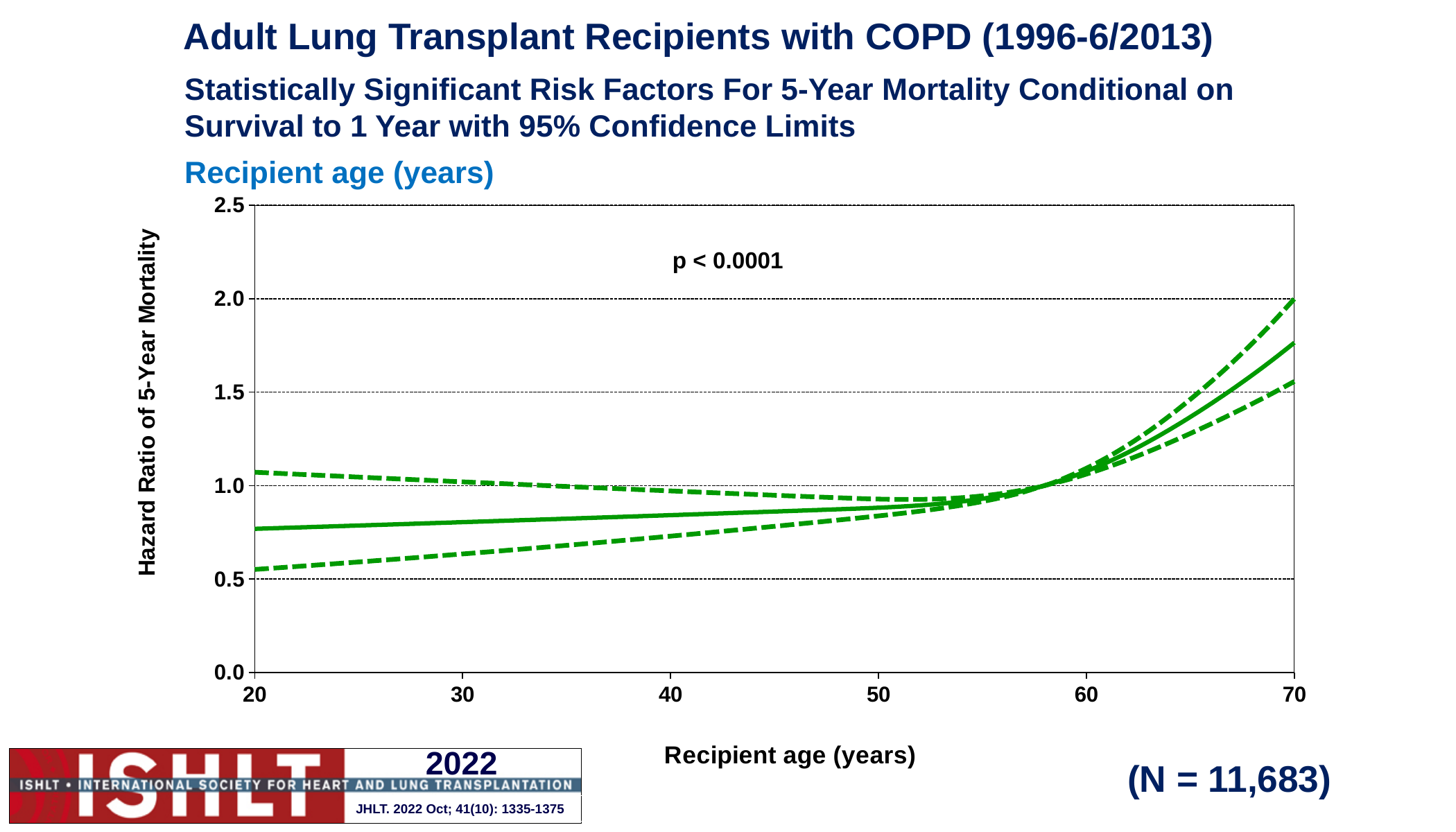
Is the hazard ratio on the solid line at recipient age 60 greater or less than 1.0? greater How many lines are plotted on the chart? 3 What p-value is printed on the chart? p < 0.0001 Does the upper dashed confidence limit rise or fall between recipient age 20 and 50? fall Is the hazard ratio on the solid line at recipient age 70 greater or less than 1.5? greater Is the upper dashed confidence limit at recipient age 70 greater or less than 1.5? greater What is the label of the y axis? Hazard Ratio of 5-Year Mortality Does the hazard ratio on the solid line rise or fall as recipient age increases from 20 to 70? rise What kind of chart is shown on the slide? line chart What is the highest value shown on the y axis? 2.5